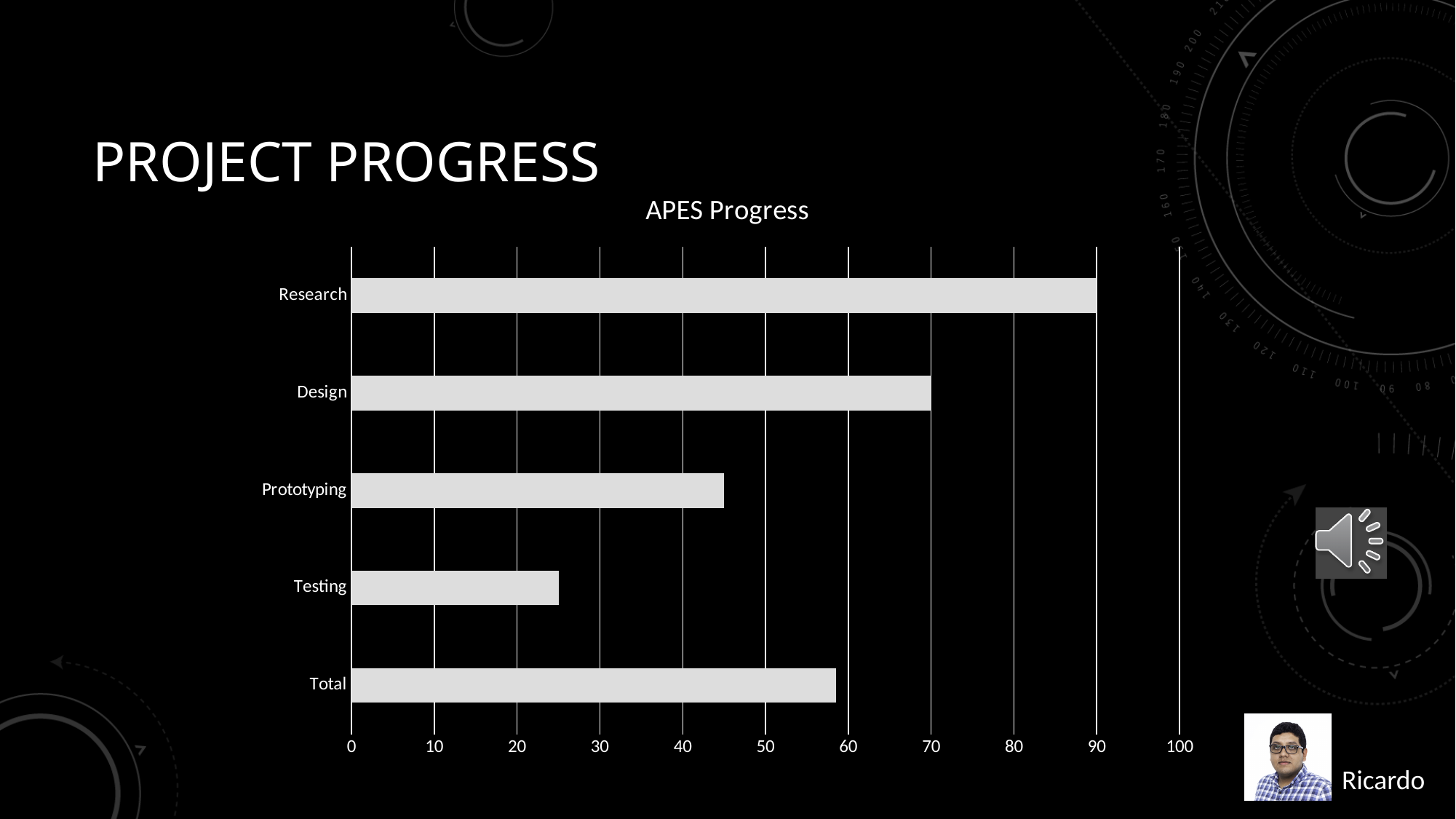
How many categories are plotted in the chart? 5 What is the value for Research? 90 What is the title of the chart? APES Progress What kind of chart is shown on the slide? bar chart What is the difference between the values for Research and Design? 20 What is the value for Design? 70 Is the value for Prototyping greater or less than 40? greater Which is larger, the value for Prototyping or the value for Total? Total Is the value for Total greater or less than 50? greater Which category has the highest value? Research Is the value for Testing greater or less than 30? less Which category has the lowest value? Testing